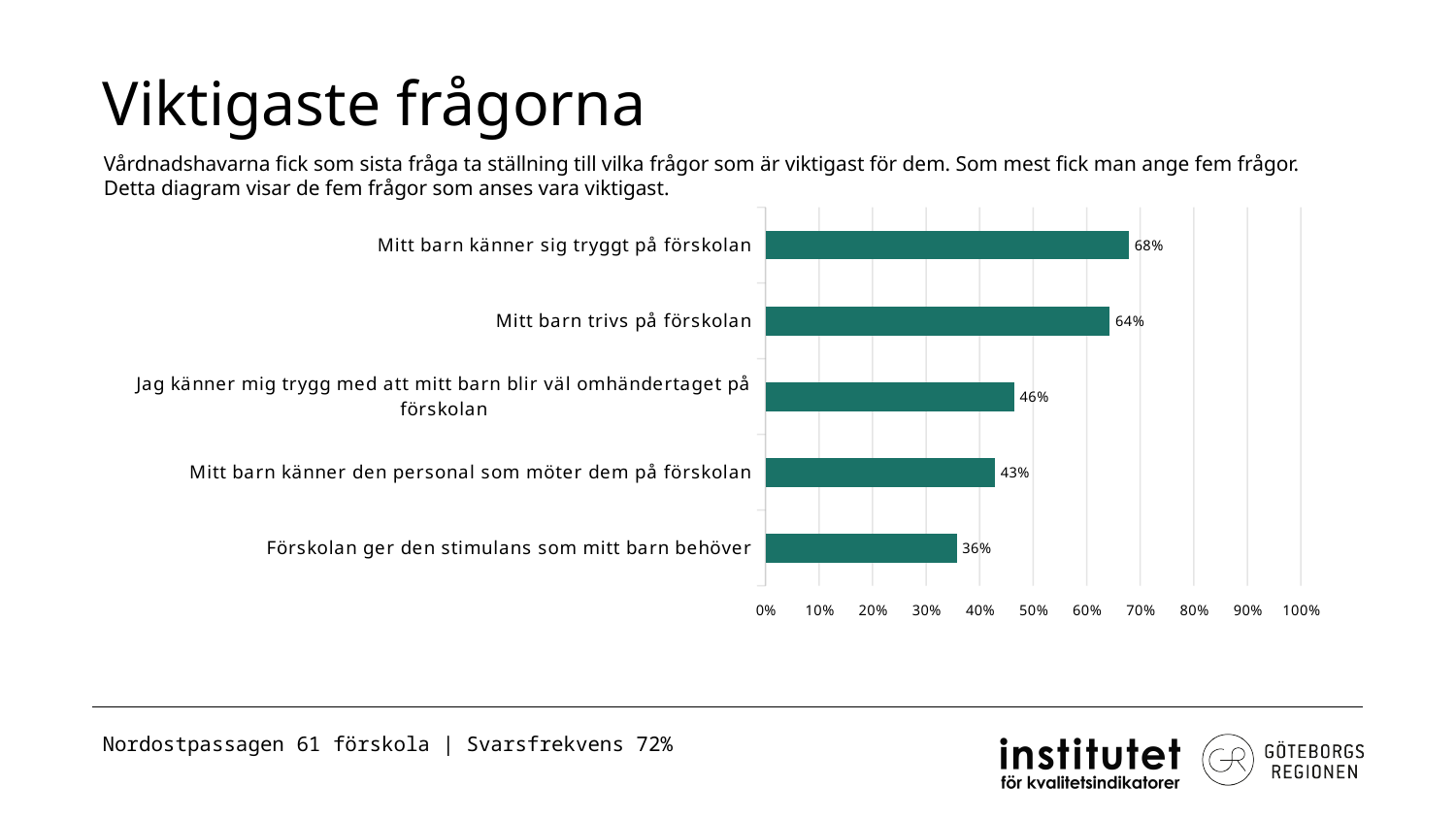
What is the difference between "Mitt barn känner sig tryggt på förskolan" and "Mitt barn trivs på förskolan"? 4% What is the value for "Mitt barn känner den personal som möter dem på förskolan"? 43% What is the difference between "Jag känner mig trygg med att mitt barn blir väl omhändertaget på förskolan" and "Förskolan ger den stimulans som mitt barn behöver"? 10% What is the value for "Förskolan ger den stimulans som mitt barn behöver"? 36% How many categories are shown in the chart? 5 Which is larger: "Mitt barn trivs på förskolan" or "Mitt barn känner den personal som möter dem på förskolan"? Mitt barn trivs på förskolan Which category has the highest value? Mitt barn känner sig tryggt på förskolan Is the value for "Jag känner mig trygg med att mitt barn blir väl omhändertaget på förskolan" greater or less than 50%? less What kind of chart is shown on the slide? Bar chart What is the title of the slide containing the chart? Viktigaste frågorna Which category has the lowest value? Förskolan ger den stimulans som mitt barn behöver What is the value for "Mitt barn känner sig tryggt på förskolan"? 68%